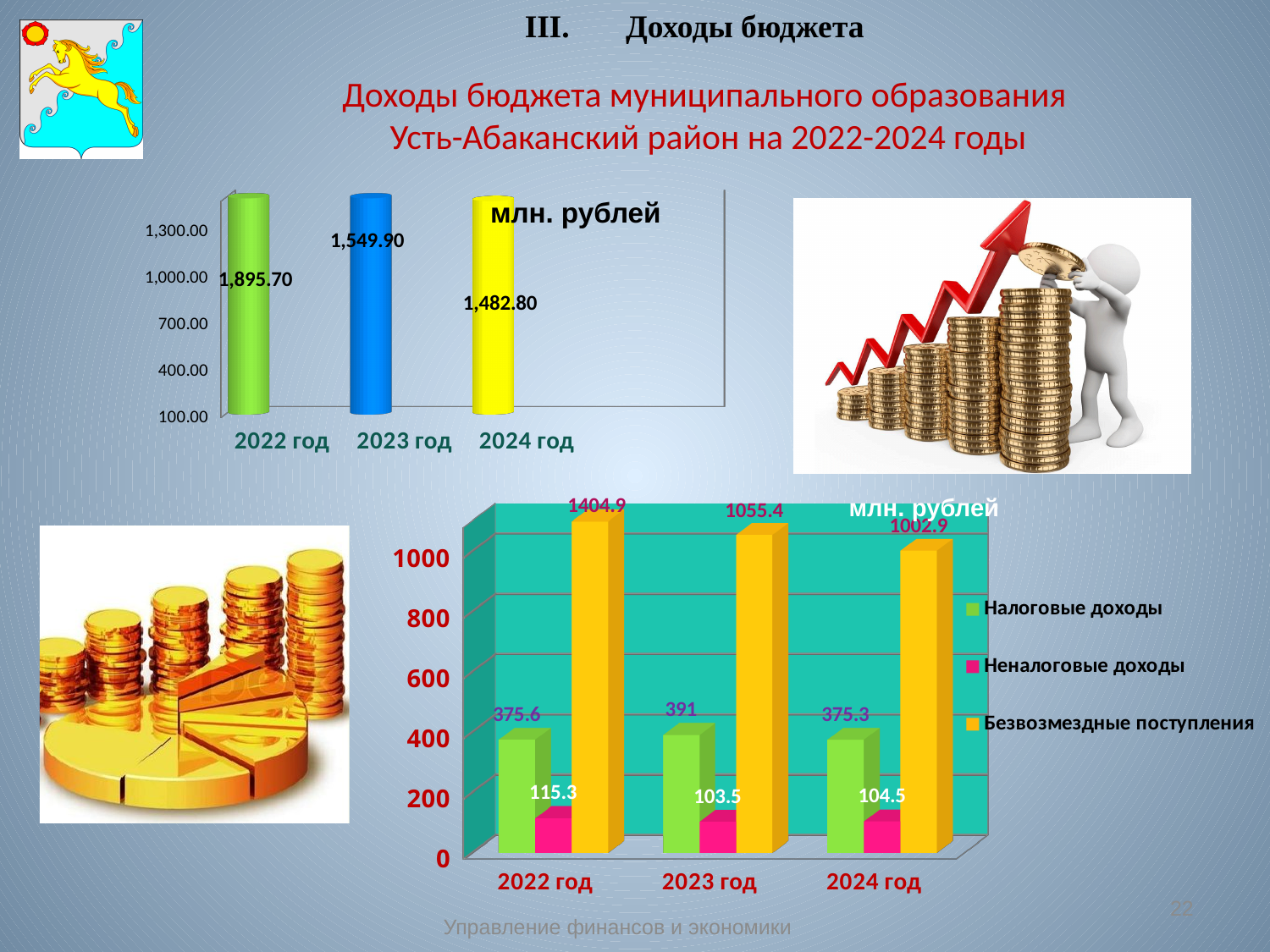
In the bottom chart, which year has the highest value for Налоговые доходы? 2023 год In the bottom chart, how many series does the legend list? 3 In the top chart, do the values rise or fall from 2022 год to 2024 год? fall In the top chart, what is the value for 2024 год? 1,482.80 In the bottom chart, what is the difference between Безвозмездные поступления for 2022 год and 2023 год? 349.5 In the top chart, what is the value for 2022 год? 1,895.70 What kind of chart is the bottom chart? bar chart In the top chart, what is the difference between the values for 2022 год and 2023 год? 345.80 In the bottom chart, what is the value of Безвозмездные поступления for 2023 год? 1055.4 In the top chart, which year has the highest value? 2022 год In the top chart, how many bars are plotted? 3 In the bottom chart, what is the value of Неналоговые доходы for 2022 год? 115.3